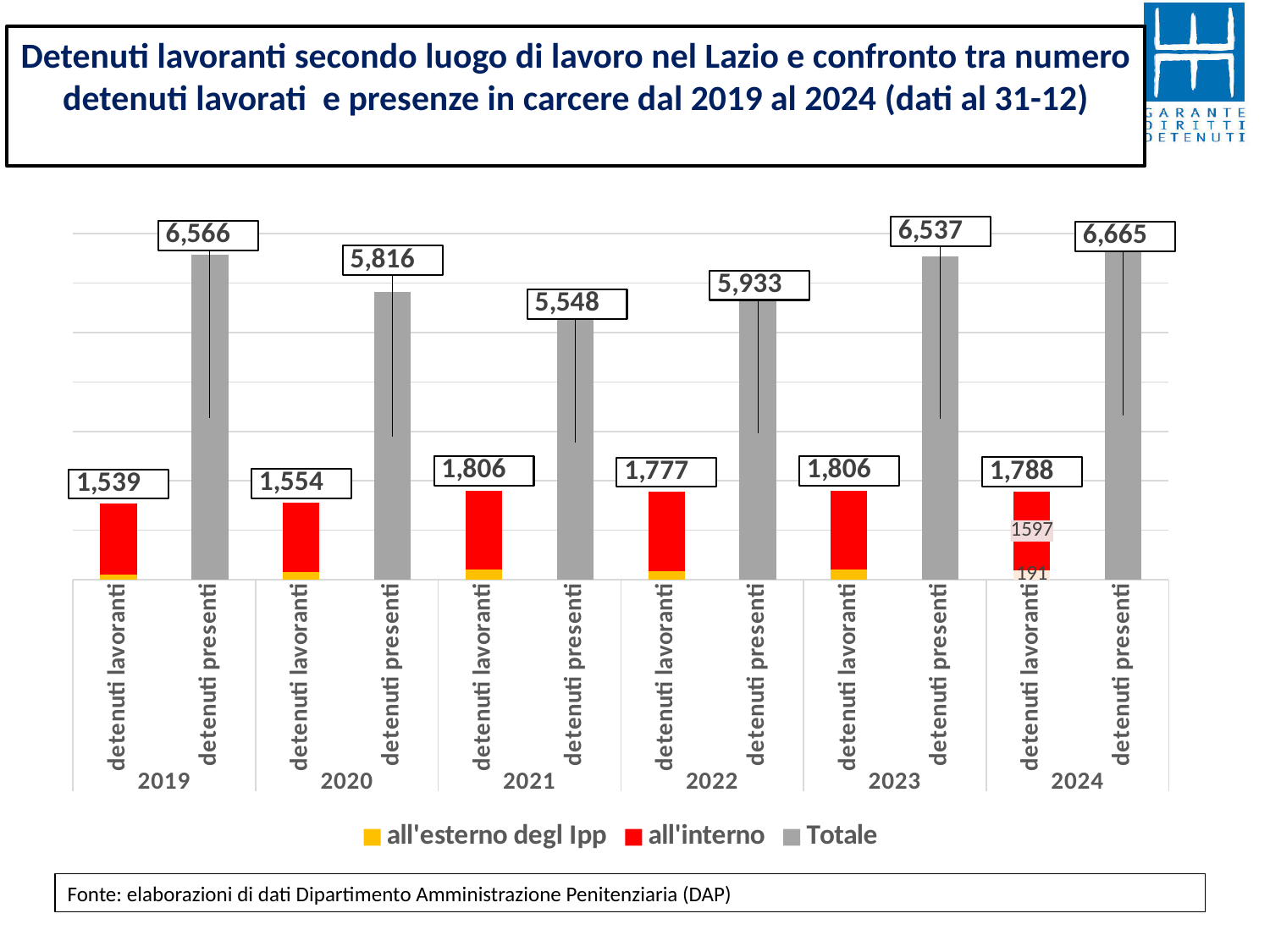
Which year has the lowest value for detenuti lavoranti? 2019 How many years are shown on the x axis? 6 What is the value for detenuti lavoranti in 2021? 1,806 Which is larger: detenuti presenti in 2020 or detenuti presenti in 2022? 2022 What kind of chart is shown on the slide? bar chart What is the value for detenuti presenti in 2019? 6,566 How many series does the legend list? 3 In 2024, what is the value labelled for the all'interno segment of the detenuti lavoranti bar? 1597 In 2024, what is the value labelled for the all'esterno degl Ipp segment of the detenuti lavoranti bar? 191 Which year has the lowest value for detenuti presenti? 2021 What is the difference between detenuti presenti and detenuti lavoranti in 2024? 4,877 Which year has the highest value for detenuti presenti? 2024